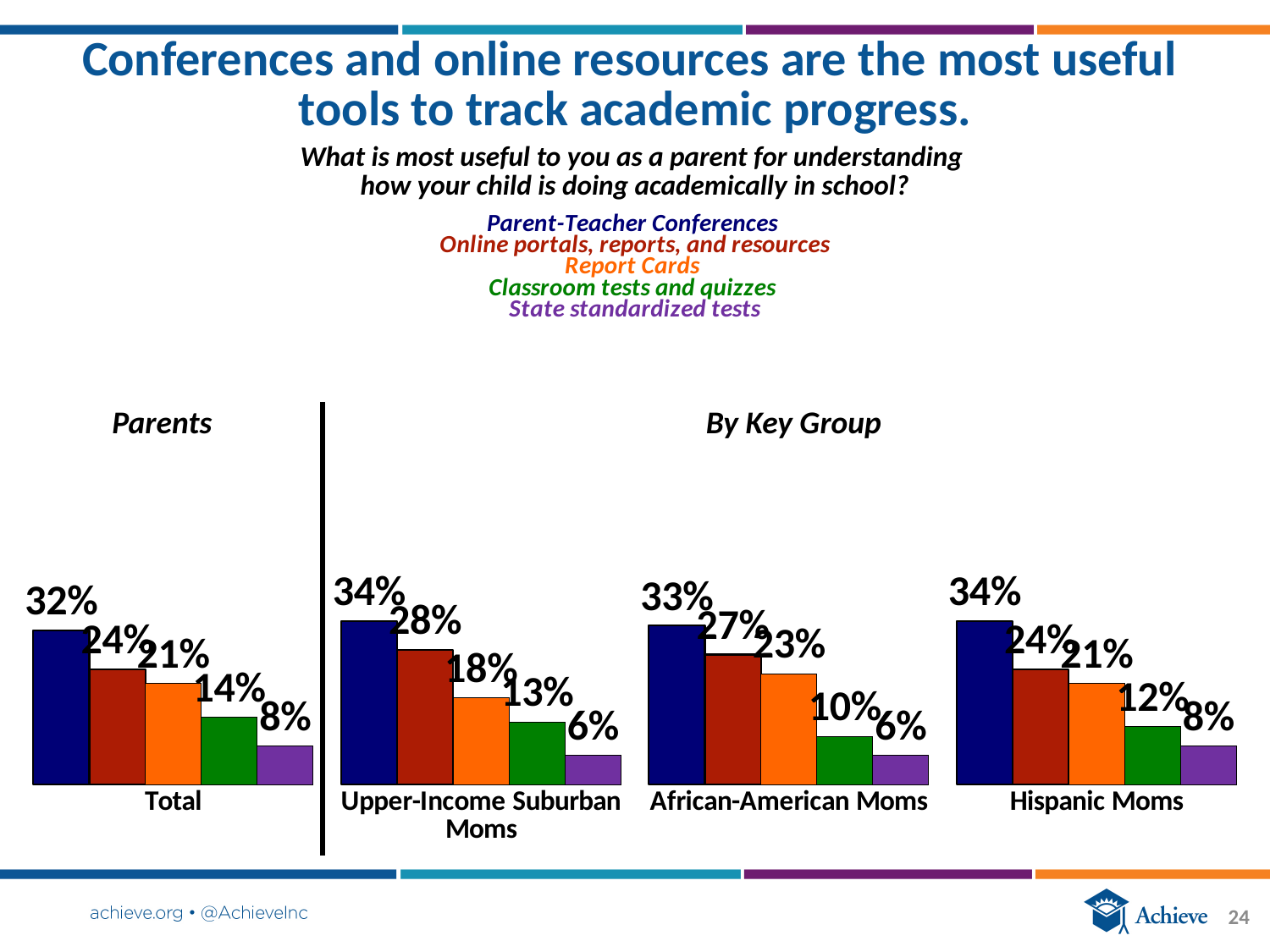
What is the difference between Parent-Teacher Conferences and State standardized tests for the Total group? 24% Which option has the lowest value for Upper-Income Suburban Moms? State standardized tests Which is larger for Hispanic Moms: Online portals, reports, and resources or Report Cards? Online portals, reports, and resources Which colour represents Report Cards in the chart? Orange What percentage of Upper-Income Suburban Moms chose Online portals, reports, and resources? 28% How many groups are shown along the x axis of the chart? 4 How many response options (series) does the chart's legend list? 5 What percentage of Hispanic Moms chose Classroom tests and quizzes? 12% What type of chart is shown on the slide? Bar chart What percentage of the Total group chose Parent-Teacher Conferences as most useful? 32% Which option has the highest value for African-American Moms? Parent-Teacher Conferences What percentage of African-American Moms chose Report Cards? 23%